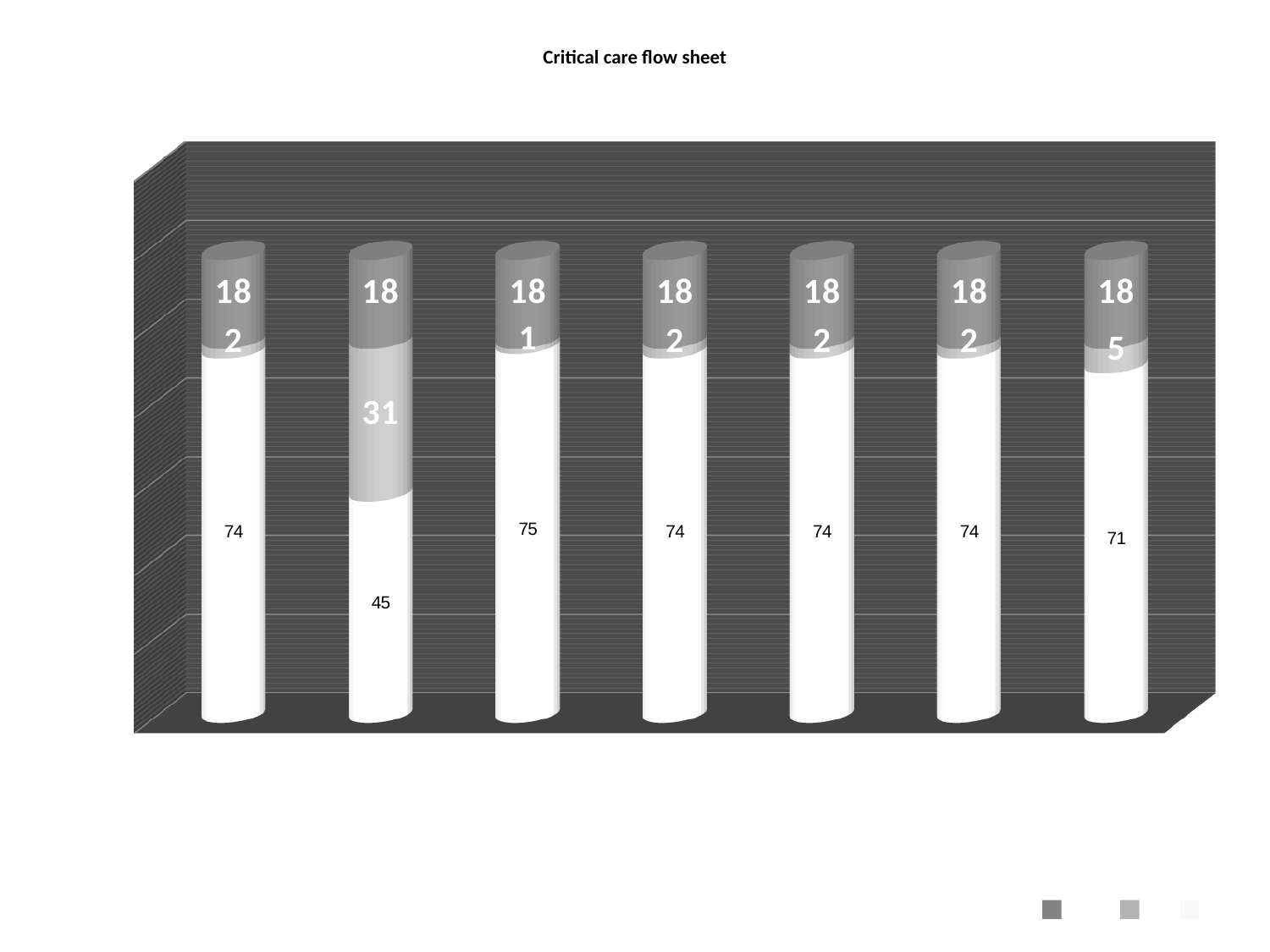
Which bar has the smallest bottom white segment? the second bar from the left (45) What is the value of the top dark grey segment of the first bar from the left? 18 What is the total of the three segments in the second bar from the left? 94 What kind of chart is shown on the slide? stacked bar chart What is the title of the chart? Critical care flow sheet How many series does the legend list? 3 What is the difference between the bottom white segment of the first bar (74) and that of the second bar (45)? 29 What is the value of the middle segment of the rightmost bar? 5 How many bars are plotted in the chart? 7 What is the value of the middle light grey segment of the second bar from the left? 31 What is the value of the bottom white segment of the second bar from the left? 45 Which bar has the largest bottom white segment? the third bar from the left (75)